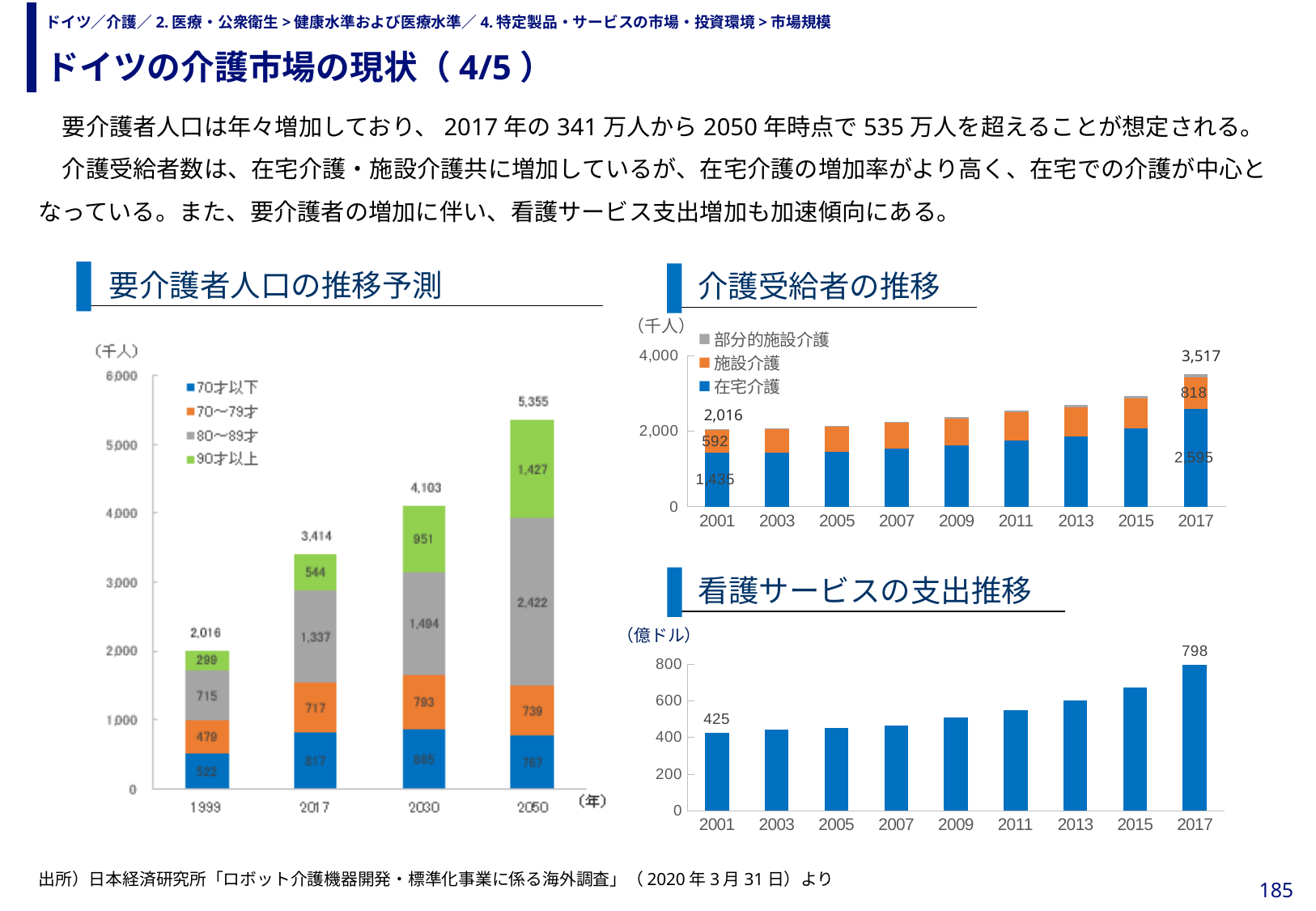
In the 要介護者人口の推移予測 chart, what is the difference between the 2050 total and the 2017 total? 1,941 In the 看護サービスの支出推移 chart, is the value for 2009 greater or less than 600? less What kind of chart is the 看護サービスの支出推移 chart? bar chart How many years are shown on the x axis of the 介護受給者の推移 chart? 9 In the 要介護者人口の推移予測 chart, which is larger: the 70才以下 value in 2030 or in 2050? 2030 In the 要介護者人口の推移予測 chart, what is the total value shown above the 2050 bar? 5,355 In the 介護受給者の推移 chart, what is the value for 在宅介護 in 2017? 2,595 How many series does the legend of the 要介護者人口の推移予測 chart list? 4 In the 看護サービスの支出推移 chart, what is the difference between the 2017 value and the 2001 value? 373 In the 介護受給者の推移 chart, what is the total shown above the 2001 bar? 2,016 In the 要介護者人口の推移予測 chart, what is the value for 80～89才 in 2030? 1,494 In the 看護サービスの支出推移 chart, what is the value for 2017? 798